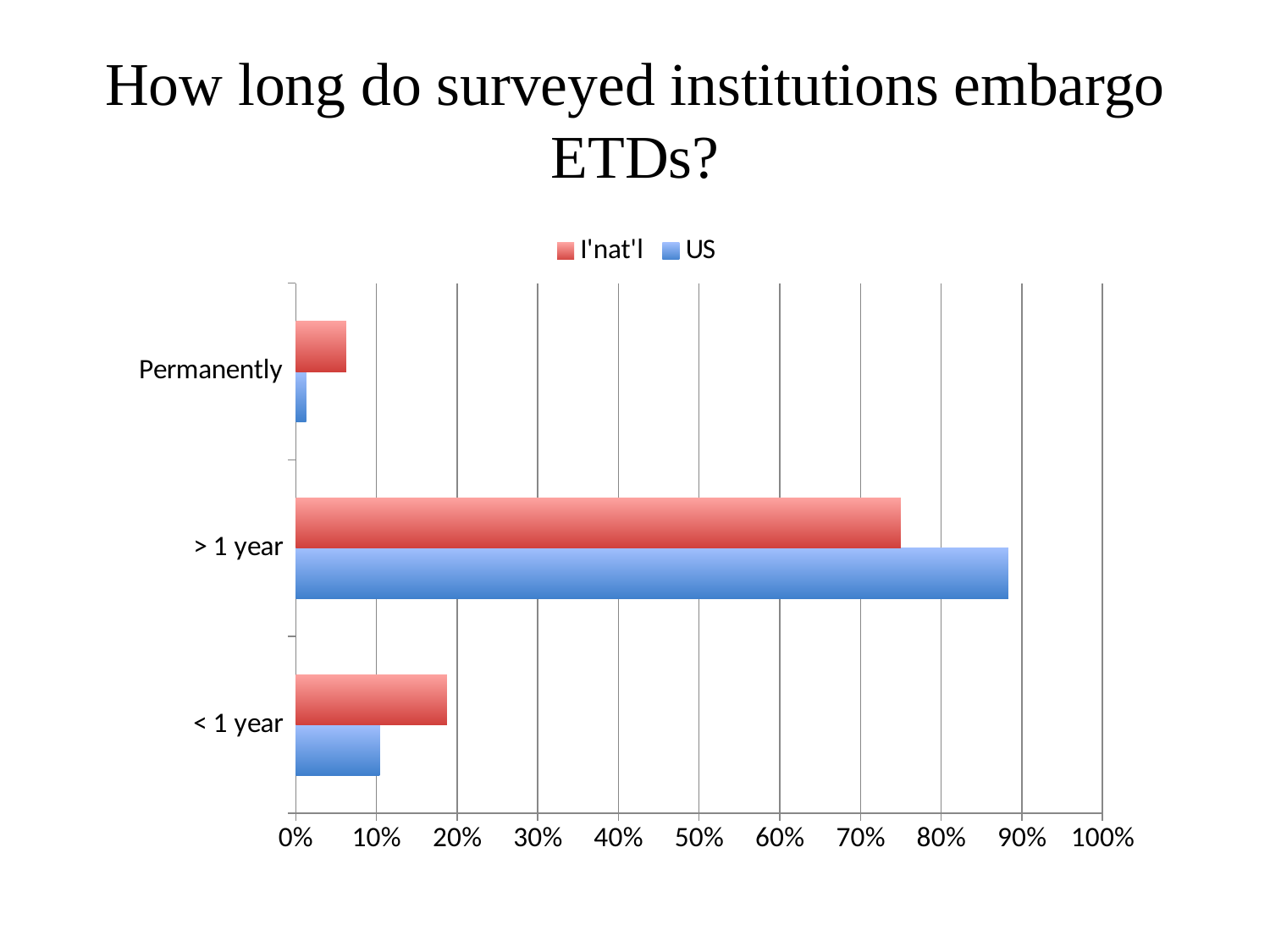
For the < 1 year category, which series has the larger value, I'nat'l or US? I'nat'l For the > 1 year category, which series has the larger value, I'nat'l or US? US What kind of chart is shown on the slide? bar chart How many series does the legend list? 2 For the Permanently category, which series has the larger value, I'nat'l or US? I'nat'l What are the two series named in the legend? I'nat'l and US Is the I'nat'l value for > 1 year greater or less than 80%? less Which category has the lowest value for the US series? Permanently How many categories are shown on the chart? 3 Which category has the highest value for the I'nat'l series? > 1 year Is the US value for > 1 year greater or less than 80%? greater Which category has the highest value for the US series? > 1 year